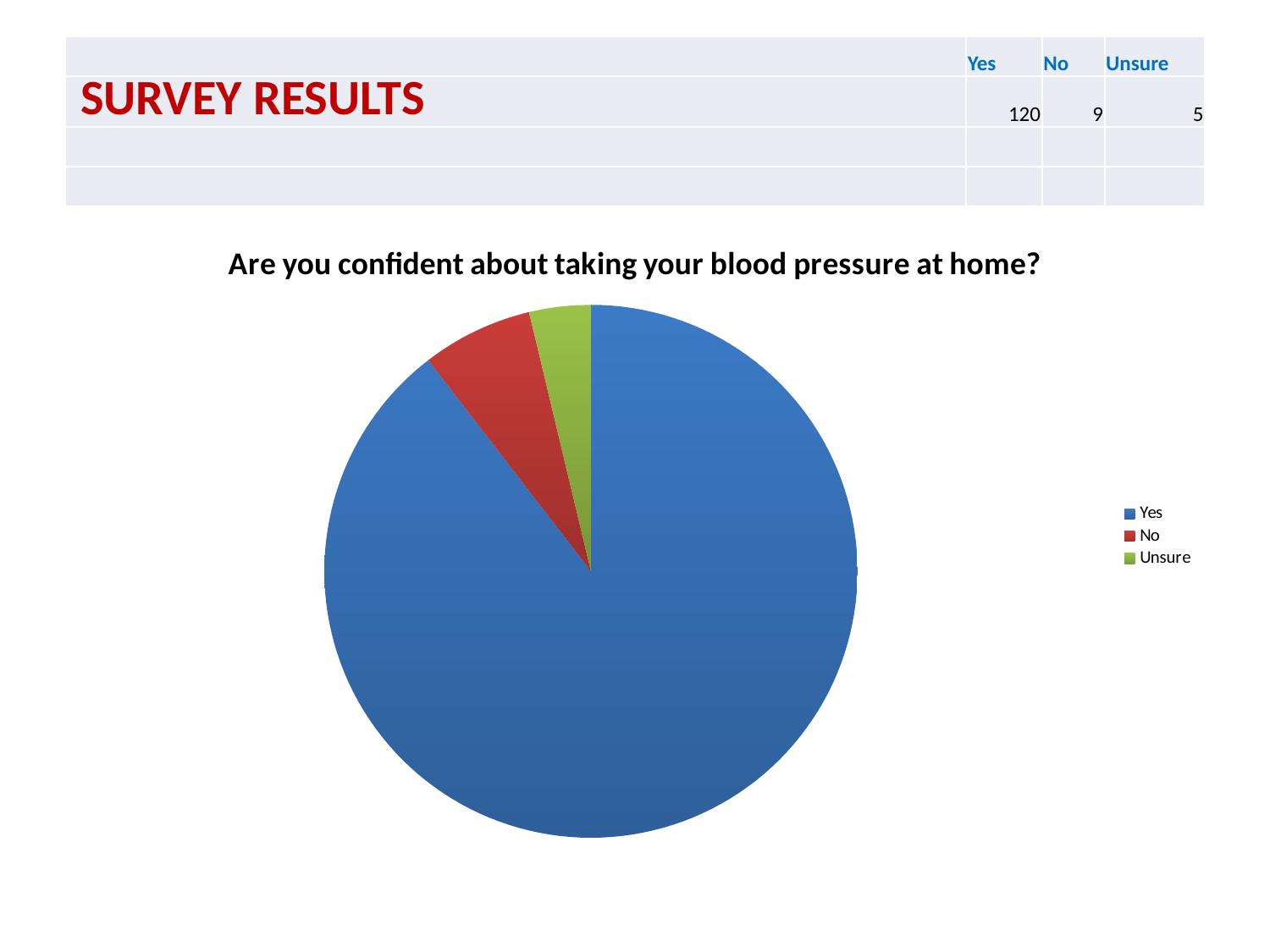
Which category has the smallest slice of the pie? Unsure What is the title of the pie chart? Are you confident about taking your blood pressure at home? What is the value for Unsure? 5 Which category has the largest slice of the pie? Yes How many entries does the legend list? 3 What is the value for Yes? 120 Which is larger, the value for No or the value for Unsure? No What is the difference between the values for Yes and No? 111 What is the value for No? 9 What is the total of all three categories? 134 How many categories does the pie chart have? 3 What kind of chart is shown on the slide? pie chart